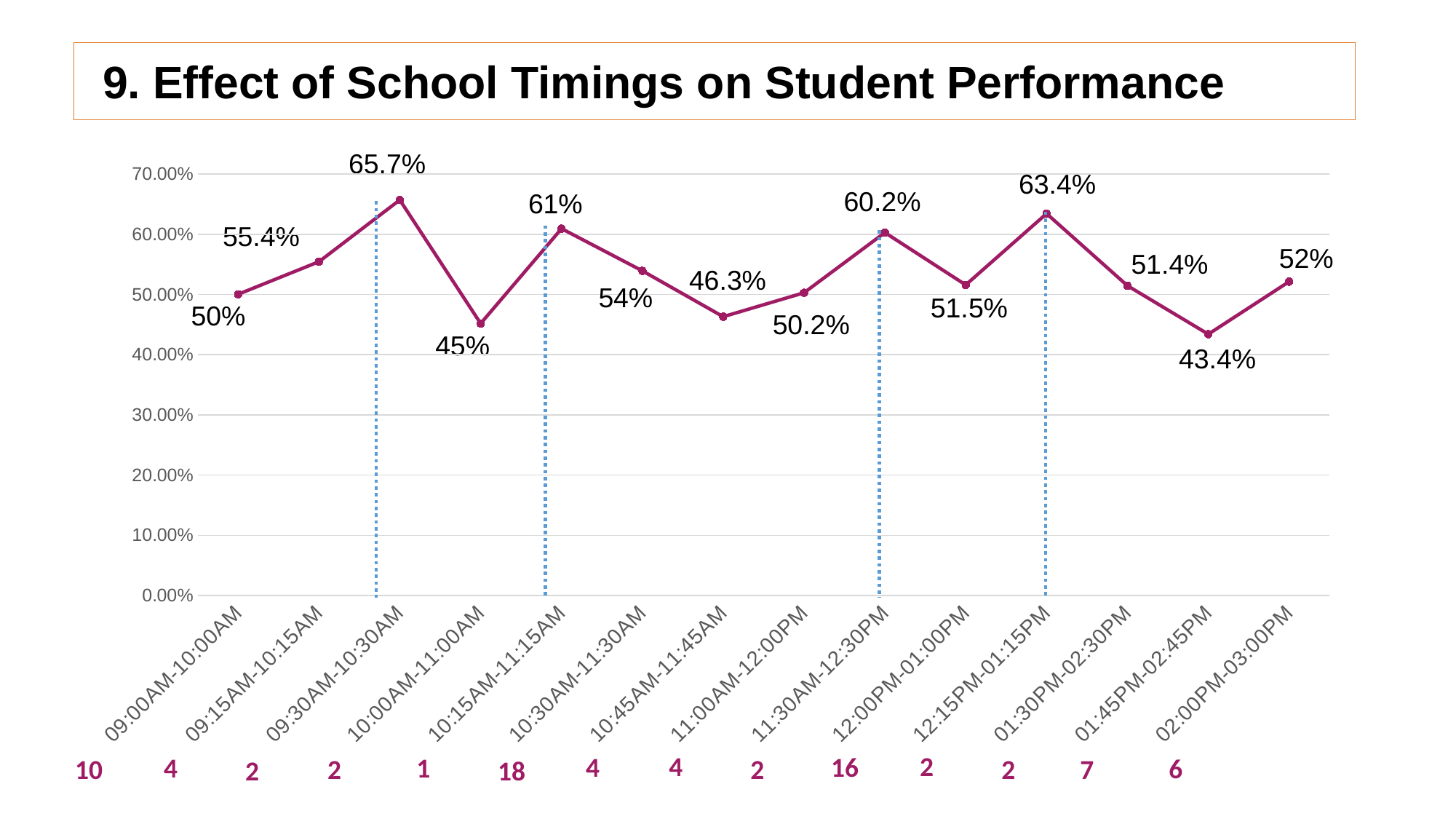
Which time slot has the highest value? 09:30AM-10:30AM What is the title of the slide? 9. Effect of School Timings on Student Performance Does the value rise or fall from 12:15PM-01:15PM to 01:30PM-02:30PM? fall How many time slots are plotted on the chart? 14 What is the value for the 11:30AM-12:30PM time slot? 60.2% What kind of chart is shown on the slide? line chart Is the value for 10:45AM-11:45AM greater or less than 50.00%? less Which is larger, the value for 10:15AM-11:15AM or the value for 12:15PM-01:15PM? 12:15PM-01:15PM What is the value for the 09:30AM-10:30AM time slot? 65.7% What is the value for the 01:45PM-02:45PM time slot? 43.4% What is the difference between the values for 09:30AM-10:30AM and 10:00AM-11:00AM? 20.7% Which time slot has the lowest value? 01:45PM-02:45PM